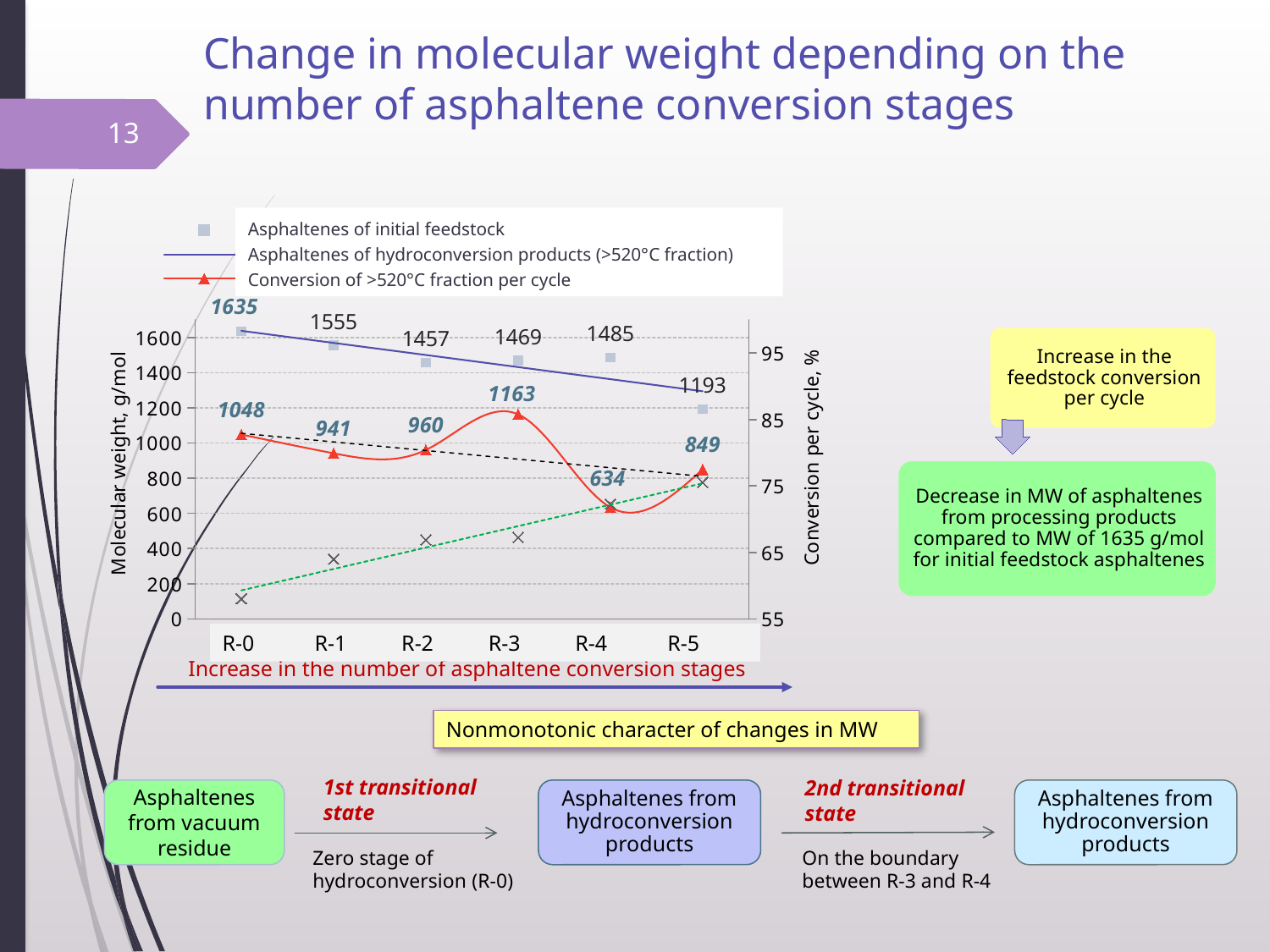
How many conversion stages are shown on the x axis? 6 Is the conversion per cycle (x-marker series) at R-0 greater or less than 65%? less What value is labelled for the triangle-marker series at R-3? 1163 What is the difference between the square-marker values at R-0 and R-5? 442 At which stage does the square-marker series reach its highest labelled value? R-0 What is the title of the right-hand vertical axis? Conversion per cycle, % What value is labelled for the triangle-marker series at R-4? 634 What value is labelled for the square-marker series at R-1? 1555 At which stage does the triangle-marker series have its lowest labelled value? R-4 Which is larger for the triangle-marker series: the value at R-1 or the value at R-2? R-2 What kind of chart is shown on the slide? line chart How many series does the legend list? 3